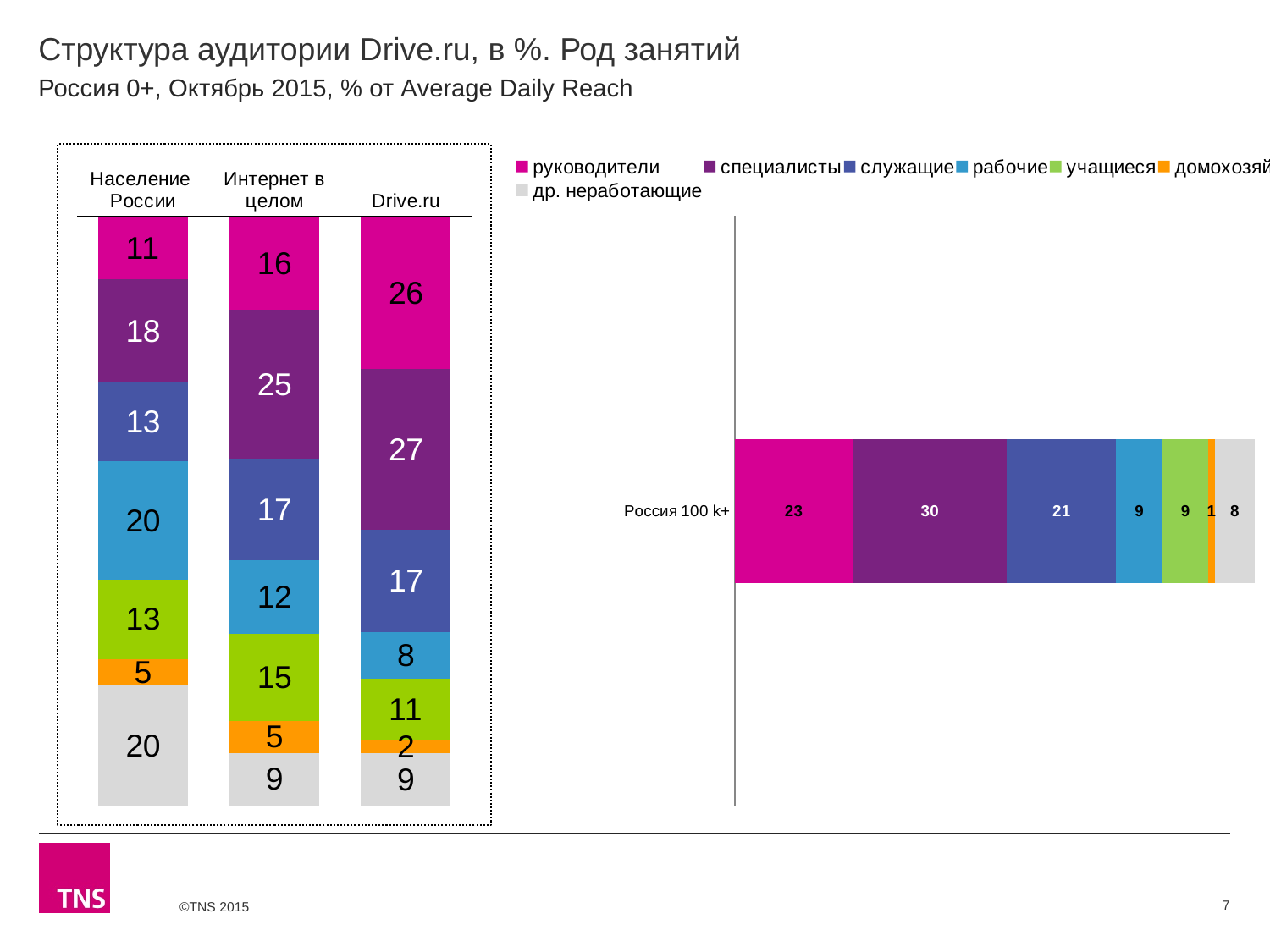
In the right chart (Россия 100 k+), which segment is the largest? специалисты In the left chart, which is larger: the light-blue segment for Население России or the light-blue segment for Drive.ru? Население России In the right chart (Россия 100 k+), what is the total of all segments? 101 In the left chart, what is the difference between the pink segment for Drive.ru and the pink segment for Население России? 15 In the right chart (Россия 100 k+), what is the value of the специалисты segment? 30 In the right chart (Россия 100 k+), which segment is the smallest? домохозяйки How many series does the legend list? 7 In the left chart, what is the value of the purple segment for Интернет в целом? 25 In the left chart, what is the value of the bottom (grey) segment for Население России? 20 In the left chart, what is the value of the top (pink) segment for Drive.ru? 26 In the left chart, how many columns (audiences) are shown? 3 What kind of chart is the left chart? stacked bar chart